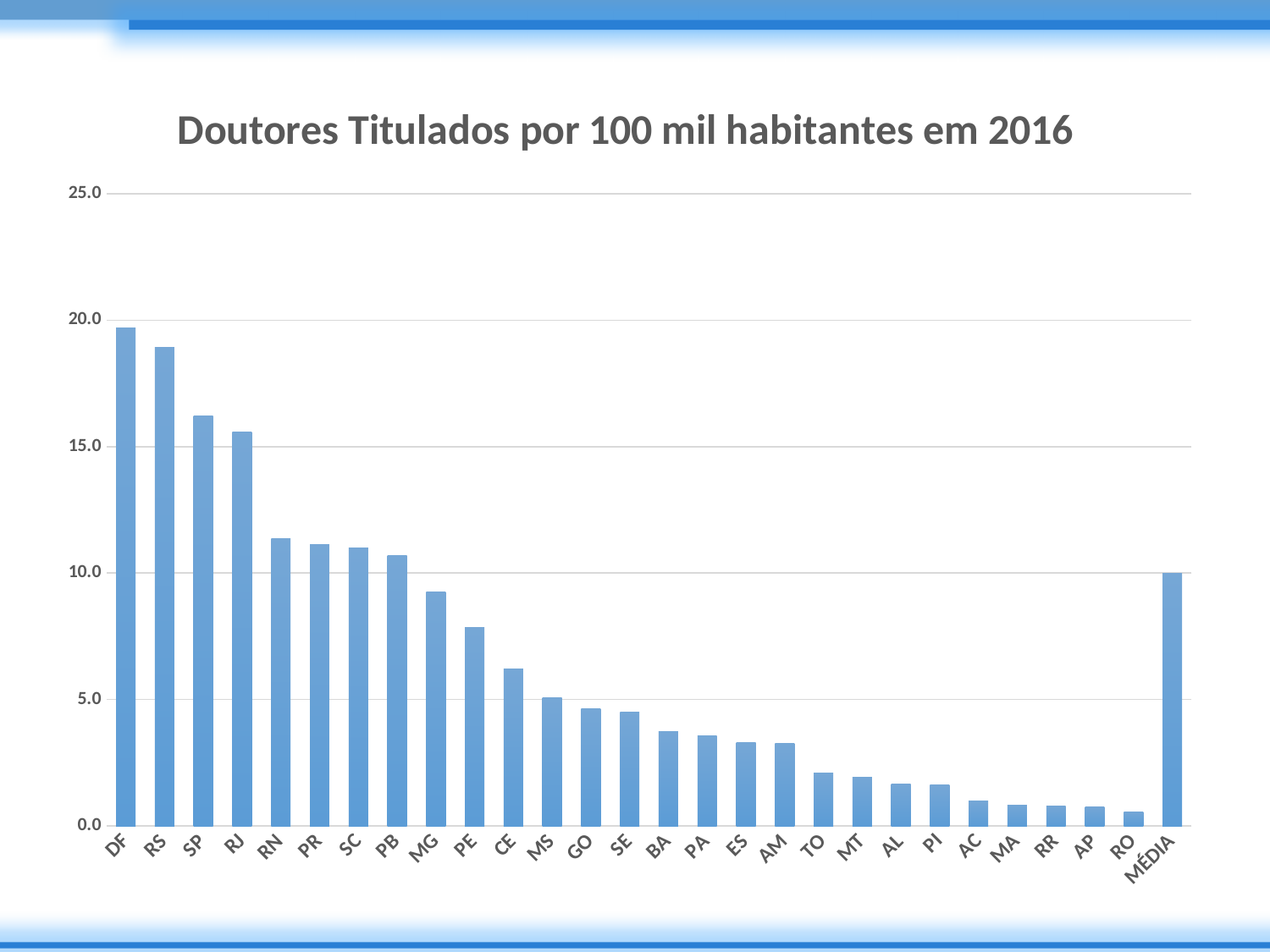
What kind of chart is shown on the slide? Bar chart Is the value for CE greater or less than 5.0? greater Is the value for SP greater or less than 15.0? greater Which has a larger value, PE or MS? PE What is the title of the chart? Doutores Titulados por 100 mil habitantes em 2016 Is the value for BA greater or less than 5.0? less How many bars are plotted in the chart? 28 Which has a larger value, RS or RJ? RS Which category has the highest value in the chart? DF Which category has the lowest value in the chart? RO